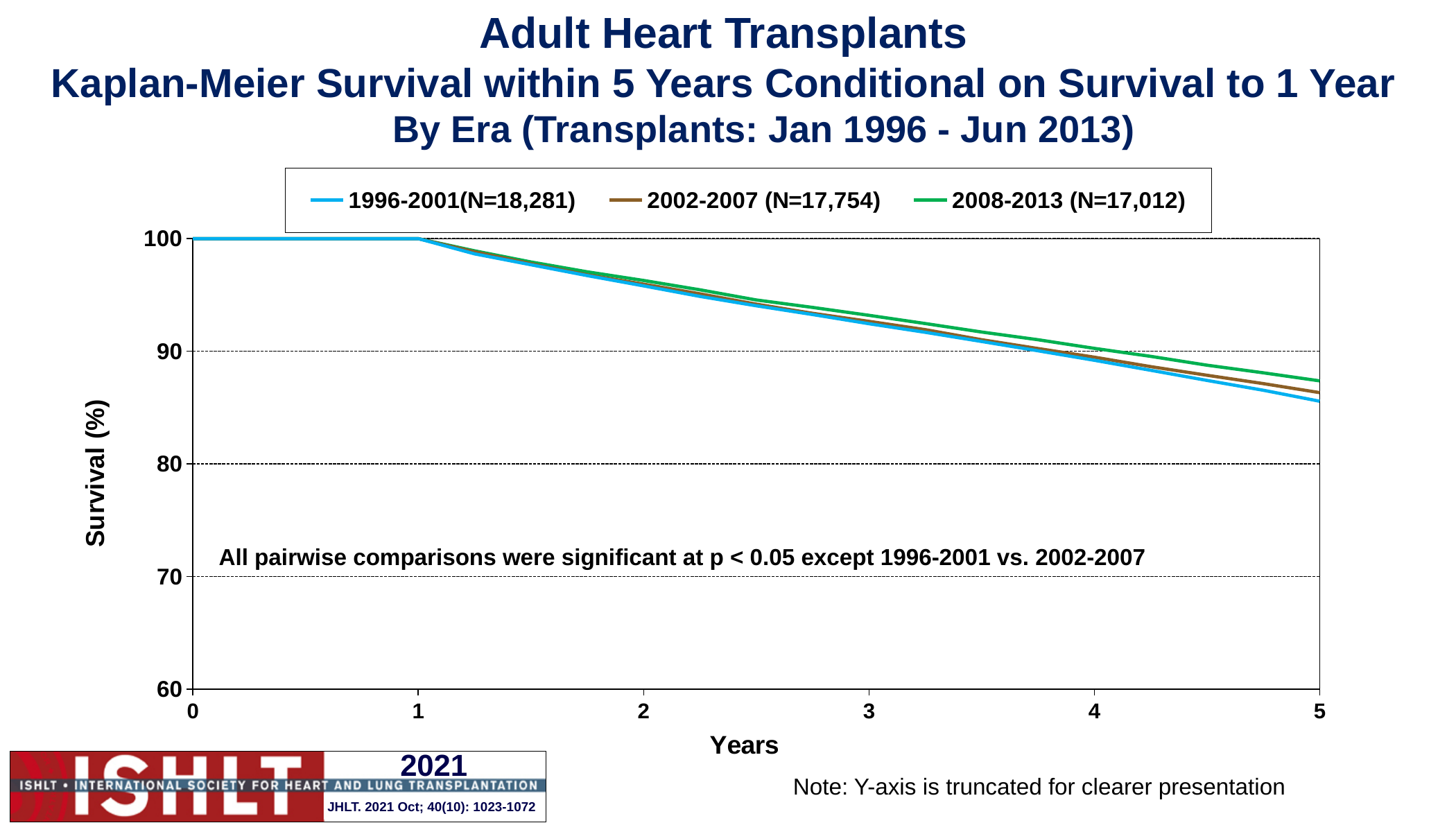
Which era has the highest survival at year 5? 2008-2013 Is the survival value for 2008-2013 at year 2 greater or less than 90? greater What is the survival value for all three eras at year 1? 100 Is the survival value for 1996-2001 at year 5 greater or less than 90? less How many series does the legend list? 3 Is the survival value for 2002-2007 at year 3 greater or less than 90? greater Which era has the lowest survival at year 5? 1996-2001 What is the N for the 2002-2007 era shown in the legend? 17,754 What is the label of the y axis? Survival (%) What kind of chart is shown on the slide? line chart Do the survival values rise or fall along the x axis after year 1? fall